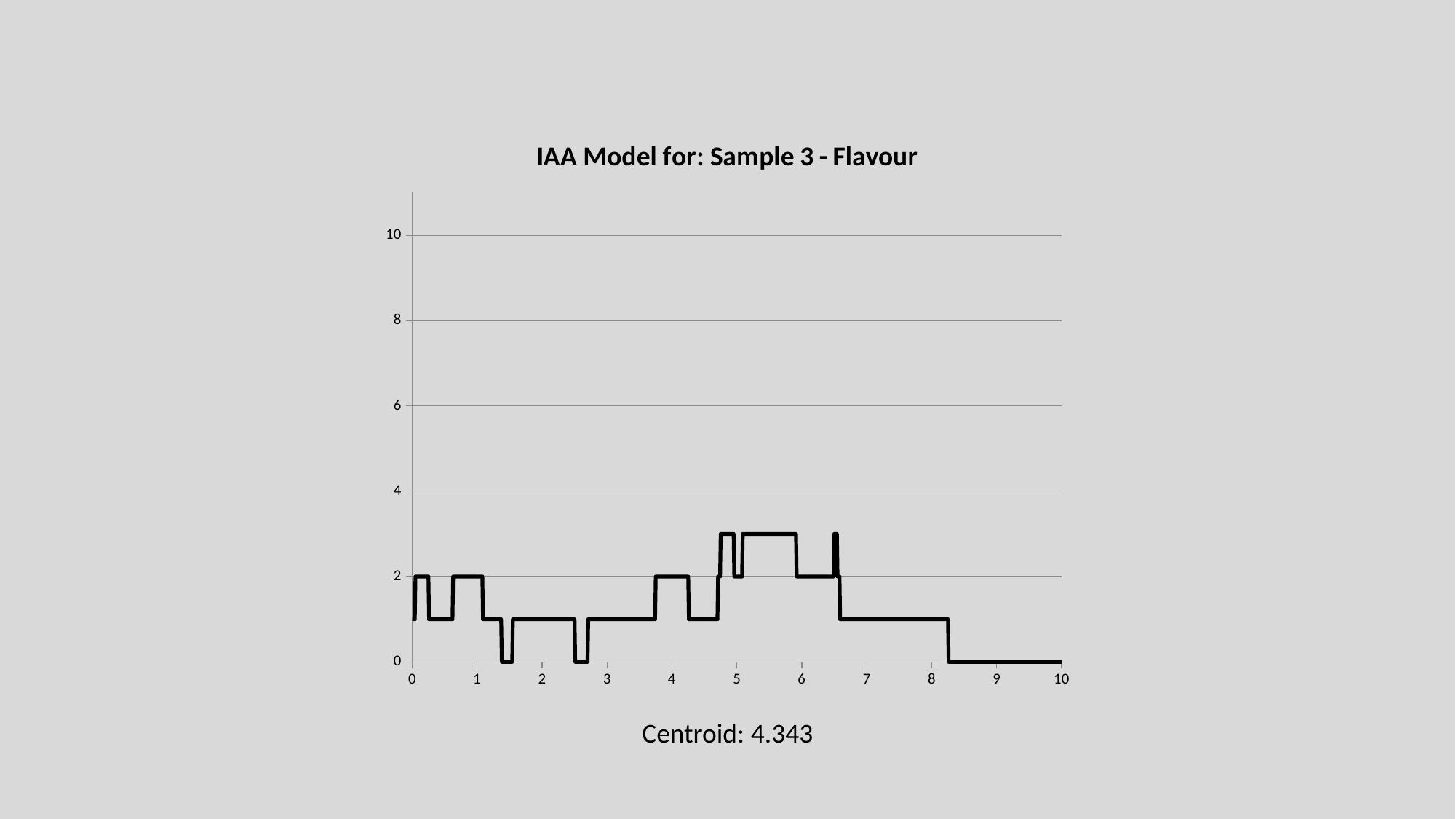
What is the title of the chart? IAA Model for: Sample 3 - Flavour Between x = 8 and x = 10, does the line rise or fall? fall What centroid value is stated below the chart? 4.343 Is the highest value reached by the line greater or less than 4? less Which is larger, the value of the line at x = 5.5 or at x = 7? x = 5.5 What is the value of the line at x = 9? 0 What is the value of the line at x = 10? 0 What kind of chart is shown on the slide? line chart Is the value of the line at x = 5.5 greater or less than 2? greater What is the value of the line at x = 4? 2 Is the value of the line at x = 7 greater or less than 2? less What is the highest value shown on the vertical axis? 10